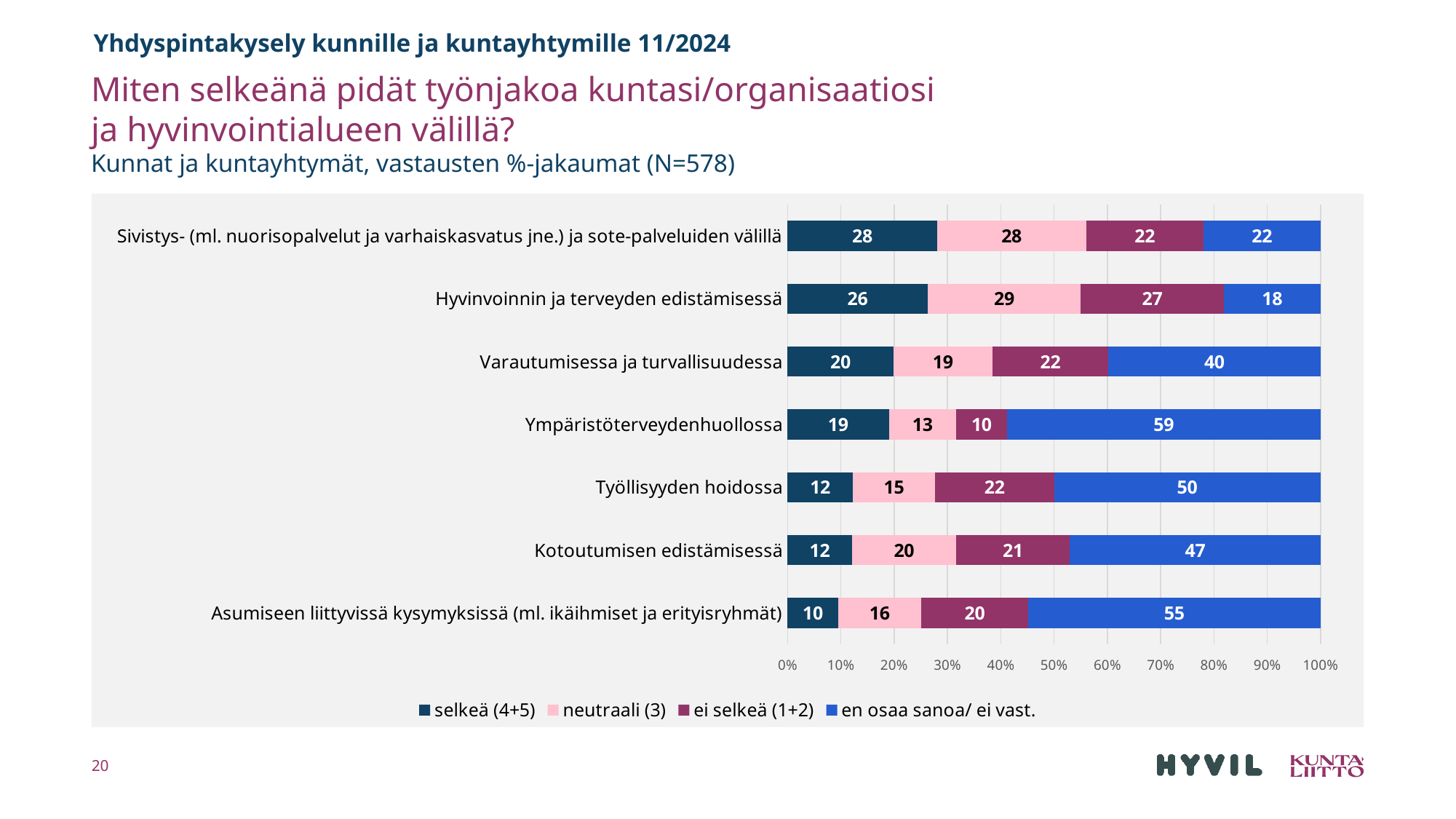
How many categories are shown on the chart? 7 Which is larger: the 'ei selkeä (1+2)' value for 'Hyvinvoinnin ja terveyden edistämisessä' or for 'Kotoutumisen edistämisessä'? Hyvinvoinnin ja terveyden edistämisessä What is the value of 'en osaa sanoa/ ei vast.' for 'Ympäristöterveydenhuollossa'? 59 How many series does the legend list? 4 What is the difference between the 'en osaa sanoa/ ei vast.' values for 'Ympäristöterveydenhuollossa' and 'Varautumisessa ja turvallisuudessa'? 19 What kind of chart is shown on the slide? Stacked bar chart What is the total of the stacked bar for 'Varautumisessa ja turvallisuudessa'? 101 What is the value of 'neutraali (3)' for 'Asumiseen liittyvissä kysymyksissä (ml. ikäihmiset ja erityisryhmät)'? 16 Which category has the highest 'selkeä (4+5)' value? Sivistys- (ml. nuorisopalvelut ja varhaiskasvatus jne.) ja sote-palveluiden välillä Which category has the lowest 'en osaa sanoa/ ei vast.' value? Hyvinvoinnin ja terveyden edistämisessä What is the value of 'ei selkeä (1+2)' for 'Työllisyyden hoidossa'? 22 What is the value of 'selkeä (4+5)' for 'Hyvinvoinnin ja terveyden edistämisessä'? 26